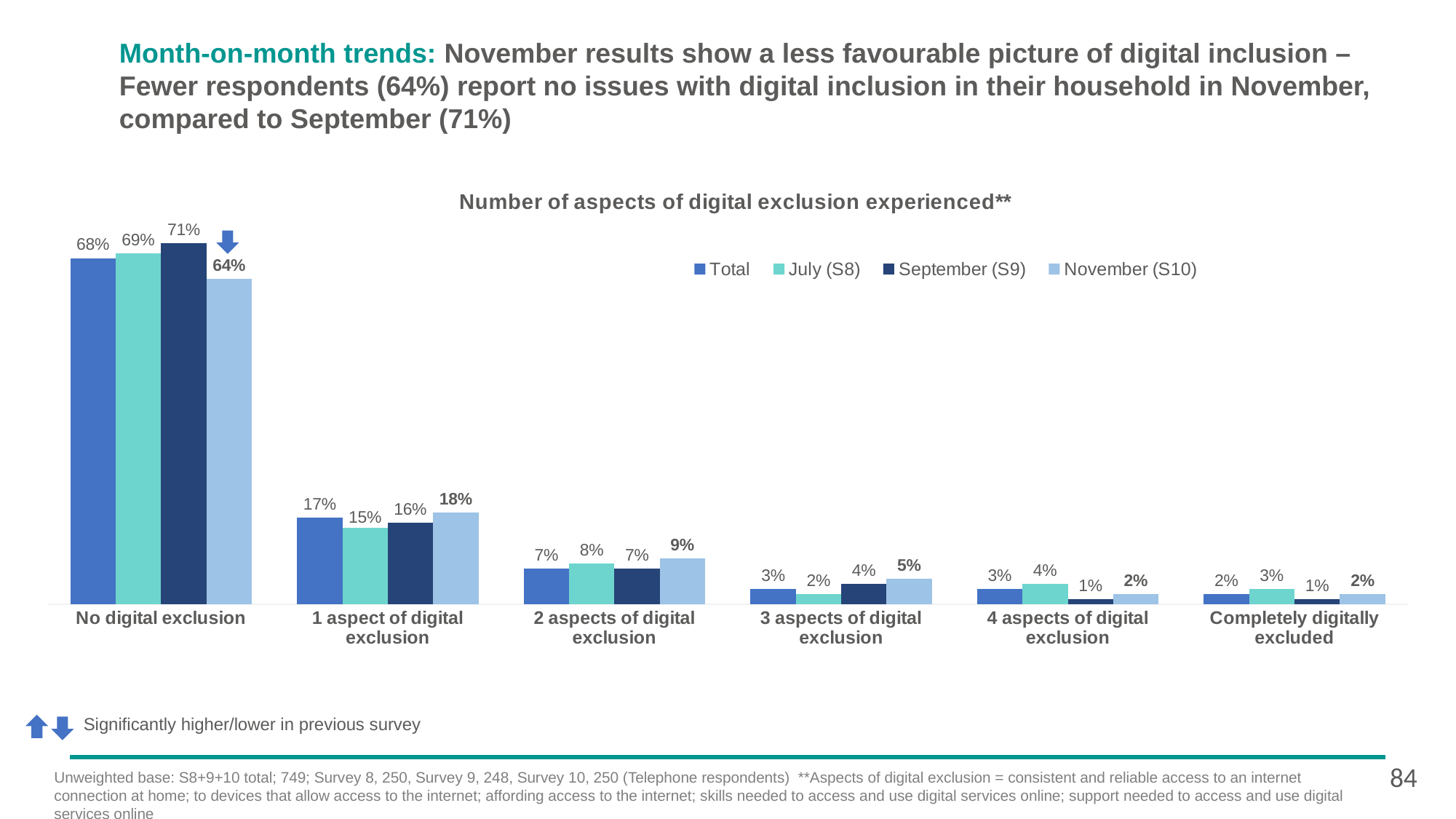
What is the November (S10) value for 'No digital exclusion'? 64% What is the July (S8) value for '2 aspects of digital exclusion'? 8% What is the November (S10) value for 'Completely digitally excluded'? 2% Which category has the highest September (S9) value? No digital exclusion What kind of chart is shown on the slide? Bar chart What is the September (S9) value for '1 aspect of digital exclusion'? 16% What is the title of the chart? Number of aspects of digital exclusion experienced** How many series does the legend list? 4 Which is larger for '4 aspects of digital exclusion': the July (S8) value or the September (S9) value? July (S8) What is the Total value for '3 aspects of digital exclusion'? 3% What is the difference between the September (S9) and November (S10) values for 'No digital exclusion'? 7% How many categories are shown on the x axis? 6